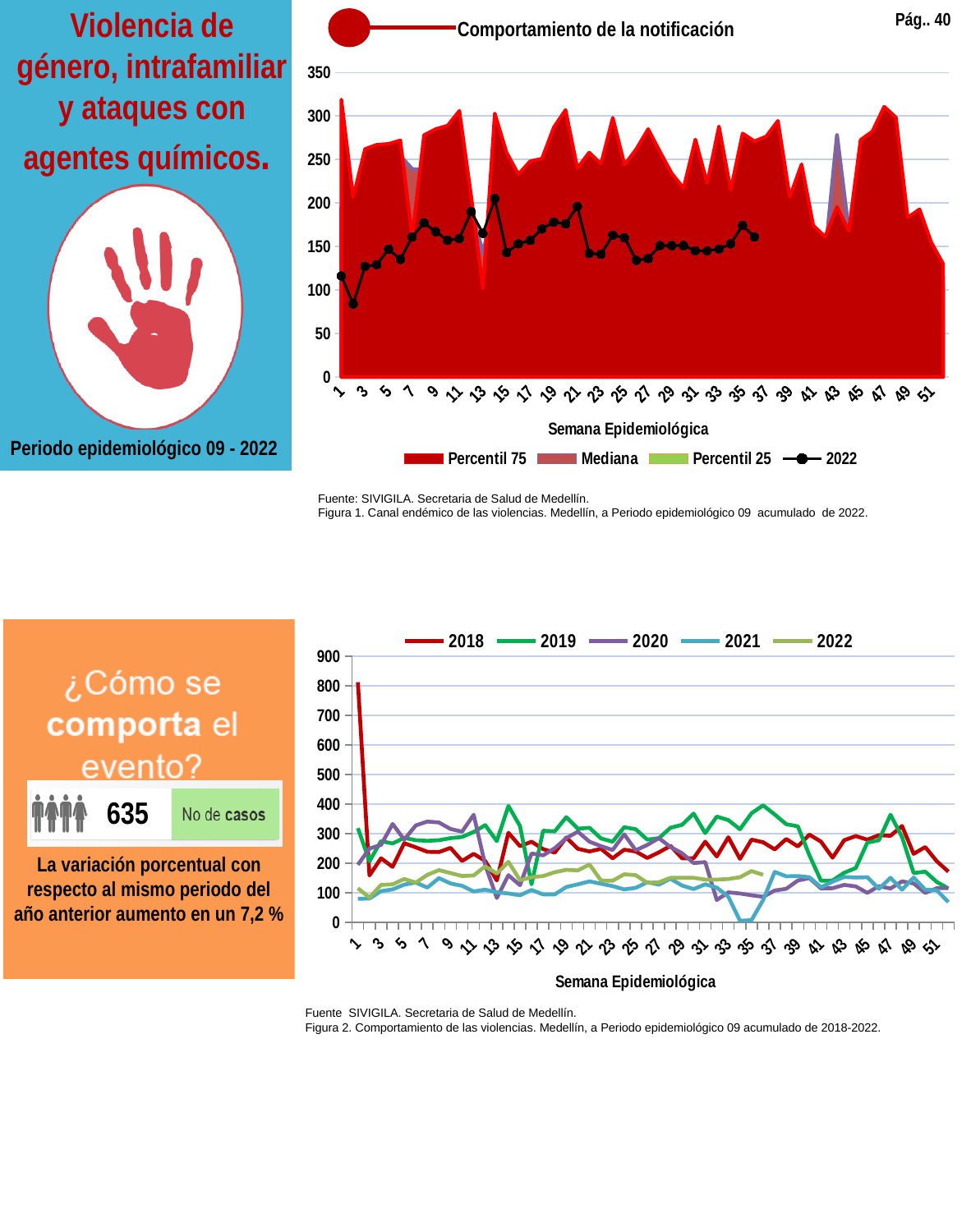
How many series does the legend of the bottom chart (Figura 2) list? 5 In the top chart 'Comportamiento de la notificación', is the 2022 value at week 2 greater or less than 100? less In the bottom chart (Figura 2), is the 2021 value at week 35 greater or less than 100? less In the top chart 'Comportamiento de la notificación', is the Percentil 75 value at week 1 greater or less than 300? greater What kind of chart is the top chart titled 'Comportamiento de la notificación'? Area chart with a line series What kind of chart is the bottom chart (Figura 2, series 2018–2022)? Line chart How many series does the legend of the top chart 'Comportamiento de la notificación' list? 4 In the top chart 'Comportamiento de la notificación', does the 2022 line rise or fall from week 1 to week 2? fall In the bottom chart (Figura 2), which series has the highest value at week 1? 2018 In the bottom chart (Figura 2), which is larger at week 1: the 2018 value or the 2019 value? 2018 In the top chart 'Comportamiento de la notificación', what is the title of the x axis? Semana Epidemiológica